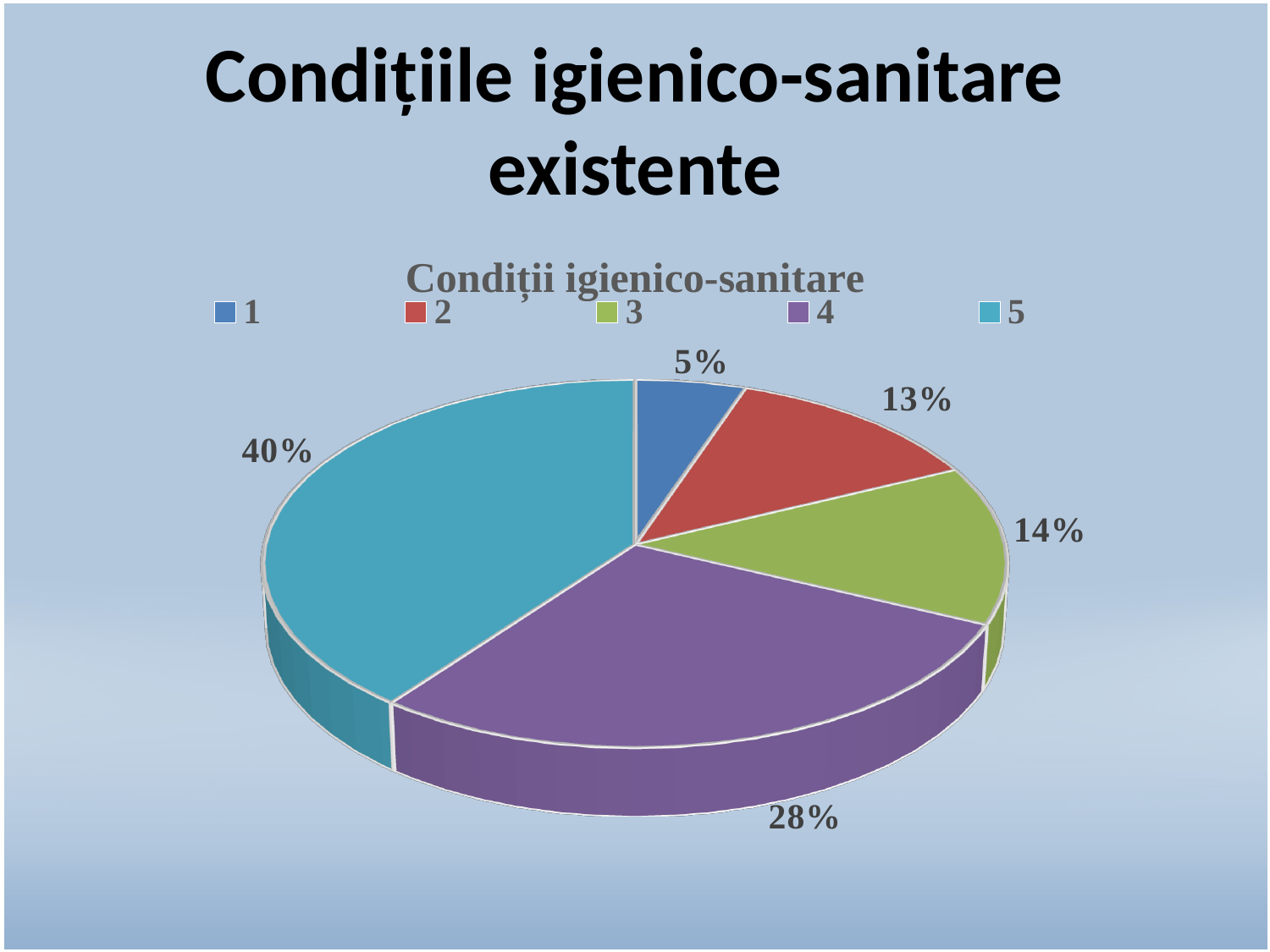
What percentage is shown for category 2? 13% What percentage is shown for category 3? 14% What is the difference in percentage points between category 5 and category 4? 12 Which category has the smallest share of the pie? 1 What kind of chart is shown on the slide? pie chart How many slices does the pie chart have? 5 What is the title of the chart? Condiții igienico-sanitare Which category has the largest share of the pie? 5 What percentage is shown for category 4? 28% What percentage is shown for category 1? 5% Which is larger, the share for category 4 or the share for category 3? 4 What percentage is shown for category 5? 40%